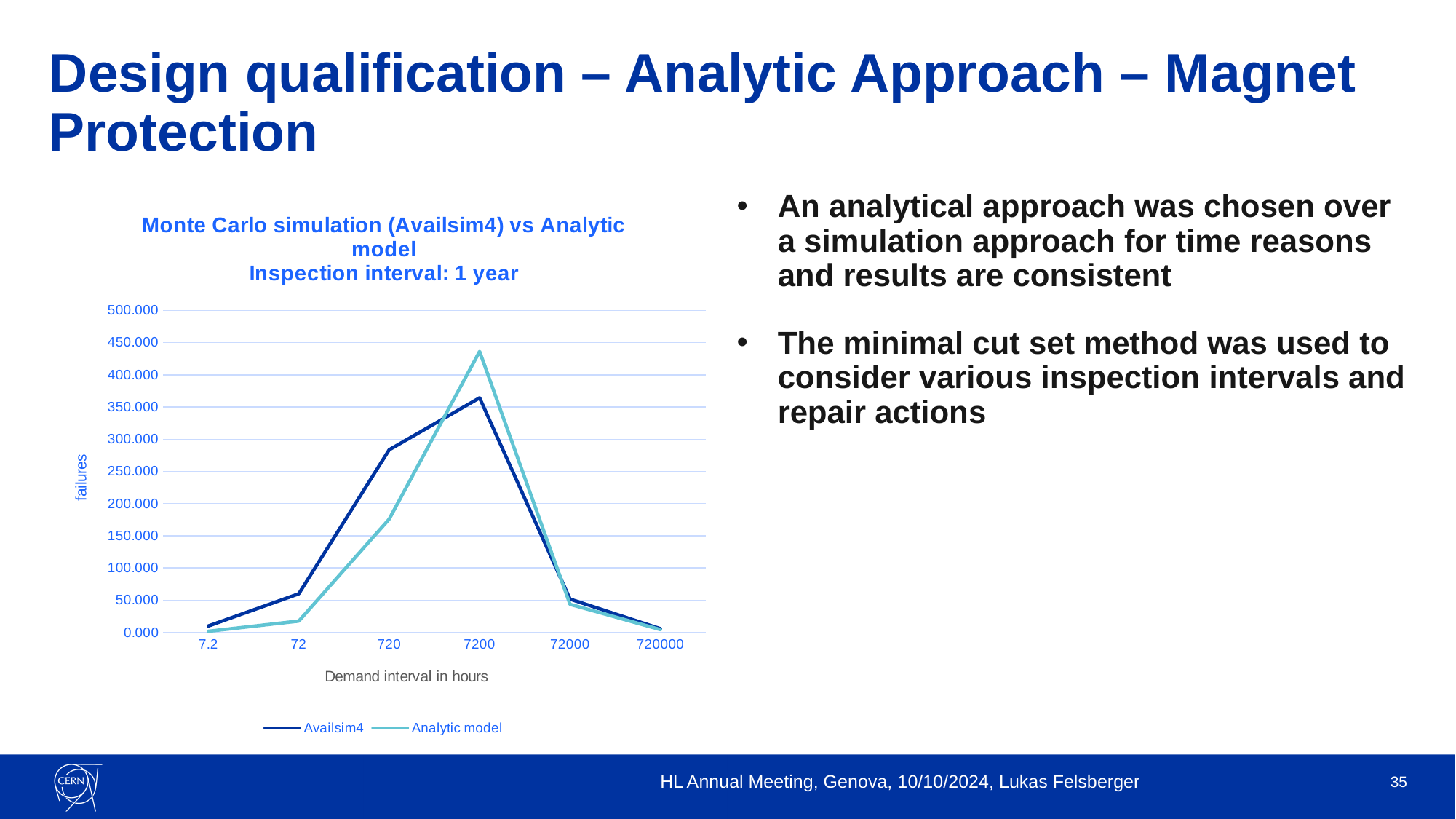
At which demand interval does the Availsim4 series reach its highest value? 7200 Do the values of both series rise or fall between demand intervals of 7200 and 720000 hours? fall What kind of chart is shown on the slide? line chart Is the value for the Analytic model at a demand interval of 7200 hours greater or less than 400.000? greater Is the value for the Analytic model at a demand interval of 72 hours greater or less than 50.000? less At a demand interval of 7200 hours, which series has the higher value, Availsim4 or Analytic model? Analytic model At a demand interval of 720 hours, which series has the higher value, Availsim4 or Analytic model? Availsim4 Is the value for Availsim4 at a demand interval of 720 hours greater or less than 250.000? greater What is the label of the x axis of the chart? Demand interval in hours At which demand interval does the Analytic model series reach its highest value? 7200 How many series does the legend list? 2 How many demand interval values are plotted along the x axis? 6